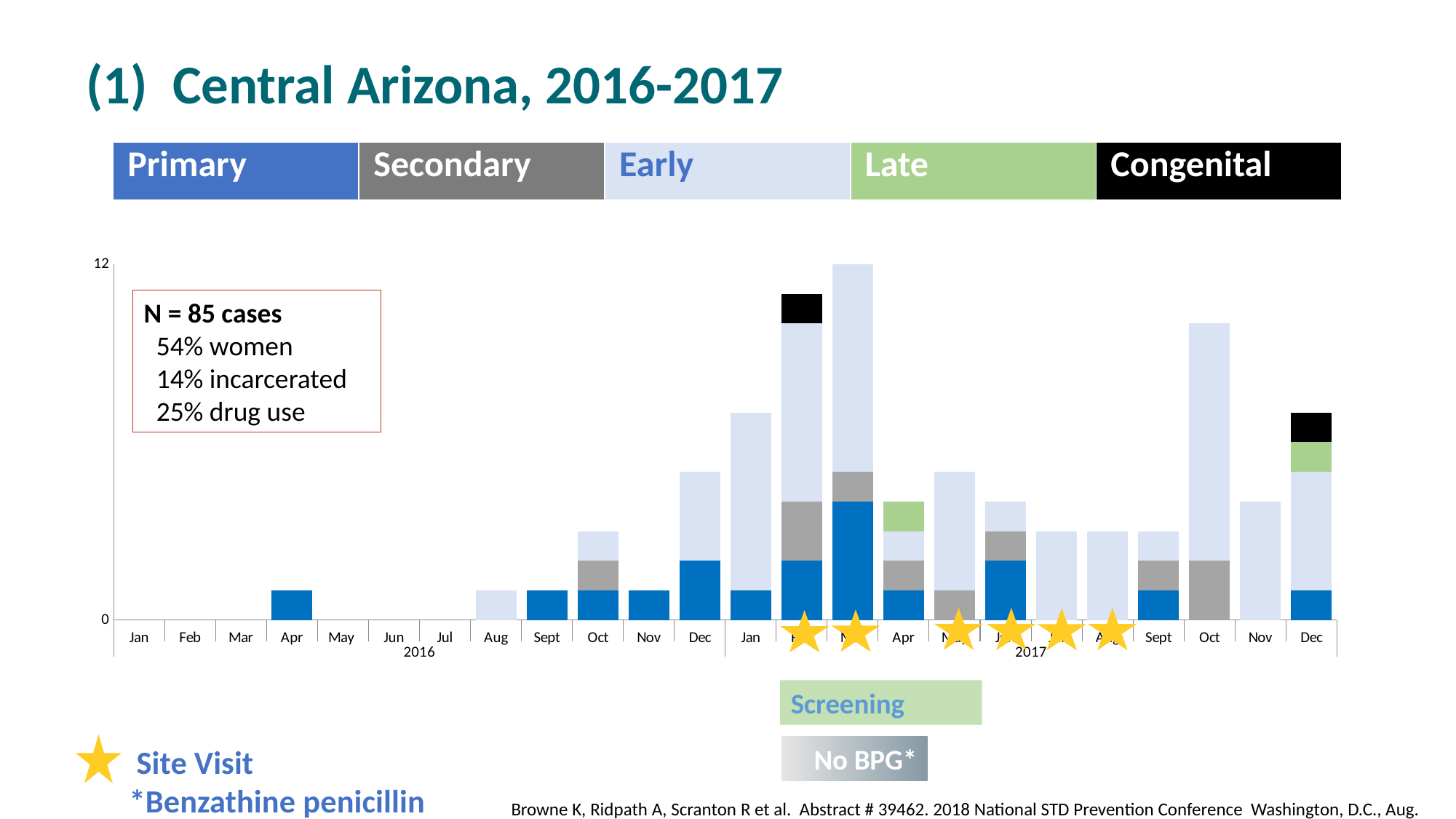
Which month has the highest total number of cases? Mar 2017 Which is larger, the total for Apr 2016 or the total for Jan 2017? Jan 2017 Which is larger, the total for Oct 2017 or the total for Nov 2017? Oct 2017 What colour represents the Congenital series? Black Do the monthly totals rise or fall from Aug 2016 to Jan 2017? Rise Is the total for Oct 2017 greater or less than 12? less How many site visit stars are shown below the x axis? 6 Which two months include Congenital cases? Feb 2017 and Dec 2017 What kind of chart is shown on the slide? Stacked bar chart In which month of 2016 does the first bar appear? Apr How many months are shown along the x axis? 24 How many series does the legend list? 5